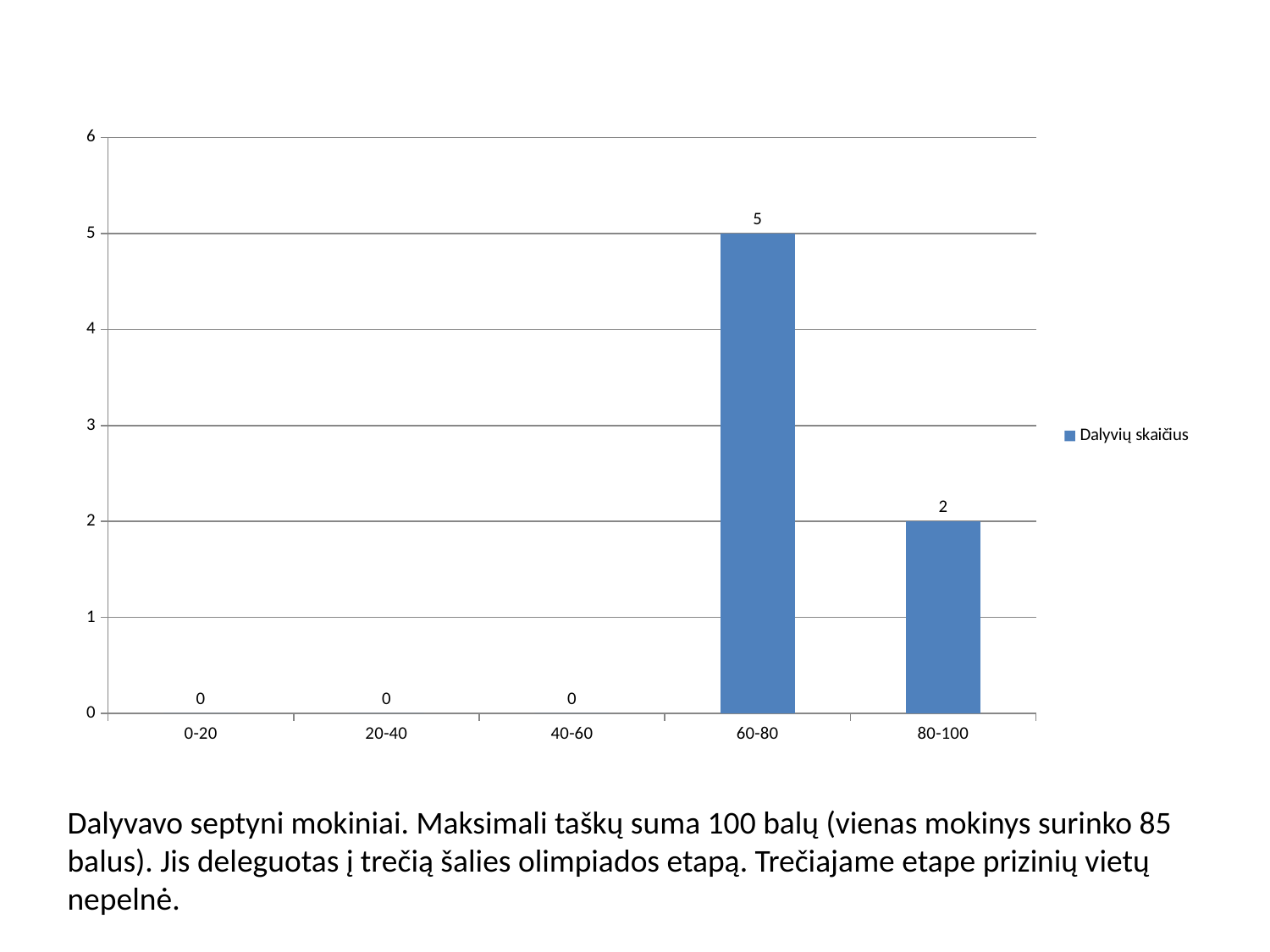
What is the value for the 80-100 category? 2 How many categories are shown on the x axis? 5 What is the name of the series in the legend? Dalyvių skaičius What kind of chart is shown on the slide? bar chart Which is larger, the value for 60-80 or the value for 80-100? 60-80 Which category has the highest value? 60-80 Is the value for 60-80 greater or less than 4? greater What is the difference between the values for 60-80 and 80-100? 3 What is the value for the 60-80 category? 5 How many series does the legend list? 1 What is the value for the 0-20 category? 0 How many categories have a value of 0? 3